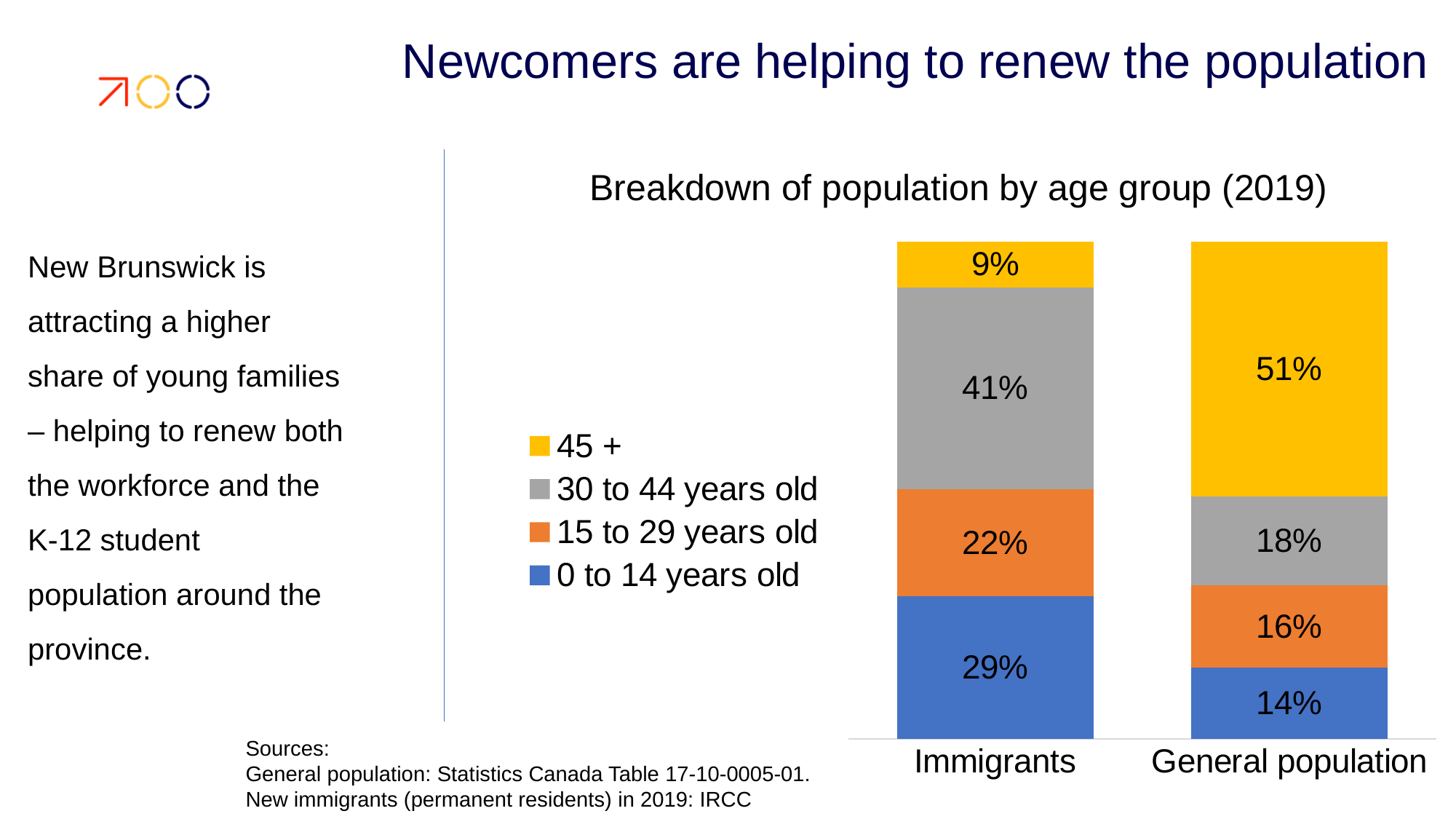
What kind of chart is shown on the slide? Stacked bar chart What is the difference between the 45 + share of the general population and the 45 + share of immigrants? 42 percentage points What percentage of the general population is 45 +? 51% What percentage of immigrants are 30 to 44 years old? 41% What percentage of immigrants are 0 to 14 years old? 29% What percentage of the general population is 15 to 29 years old? 16% How many series does the legend list? 4 How many categories (bars) are shown on the x axis? 2 Which age group is the largest share of the Immigrants bar? 30 to 44 years old Which group has a larger share of 0 to 14 year olds, Immigrants or General population? Immigrants What is the title of the chart? Breakdown of population by age group (2019) Which age group is the smallest share of the General population bar? 0 to 14 years old